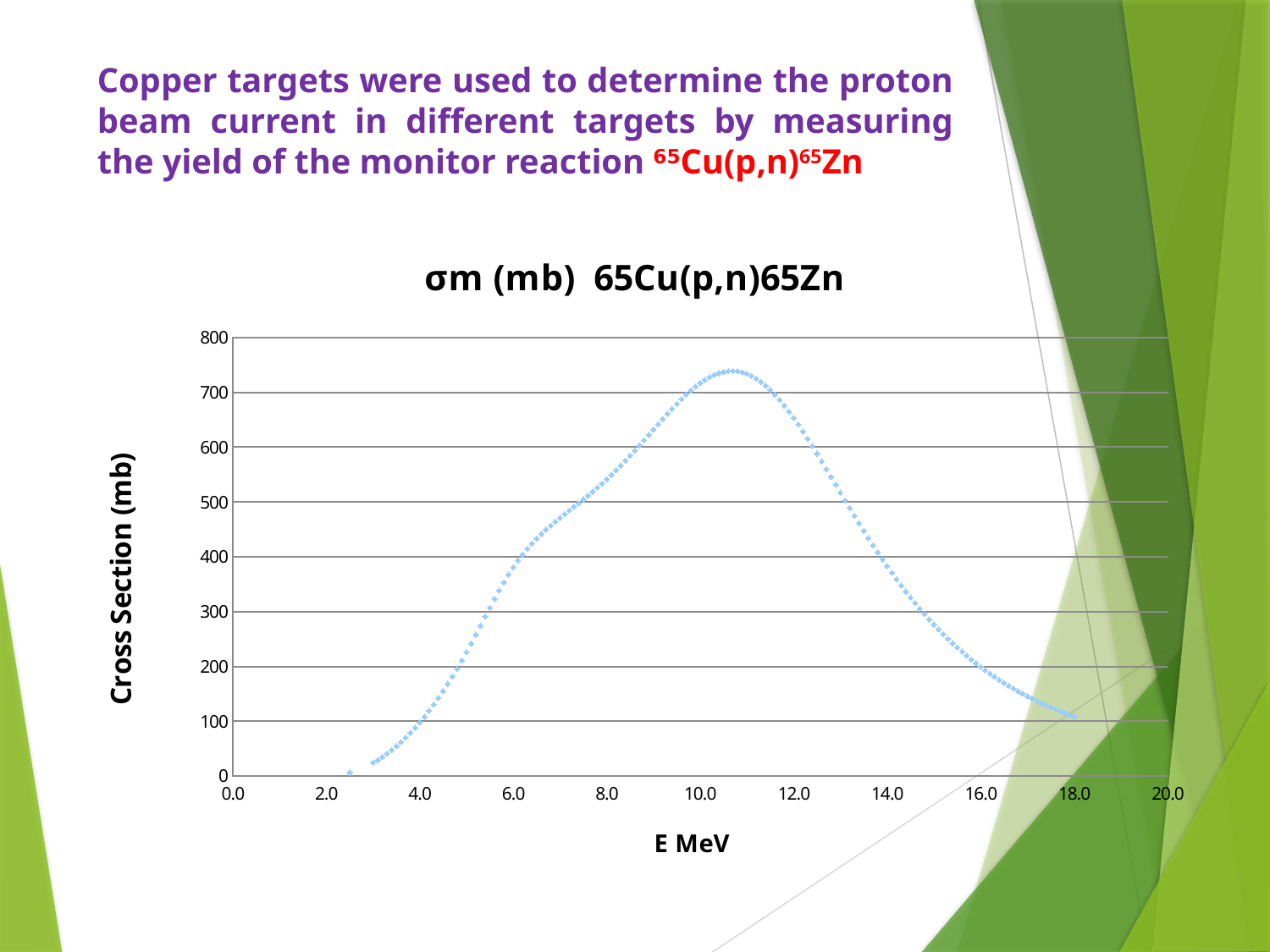
Is the peak cross section on the chart greater or less than 700 mb? greater Is the cross section at 12.0 MeV greater or less than 600 mb? greater What is the title of the chart? σm (mb) 65Cu(p,n)65Zn Does the cross section rise or fall as the energy increases from 12.0 MeV to 18.0 MeV? fall Between which two labelled x-axis ticks does the cross section reach its maximum? 10.0 and 12.0 What is the label of the vertical axis of the chart? Cross Section (mb) Is the cross section at 8.0 MeV greater or less than 500 mb? greater What kind of chart is shown on the slide? scatter chart Which is larger, the cross section at 8.0 MeV or at 14.0 MeV? 8.0 MeV Does the cross section rise or fall as the energy increases from 4.0 MeV to 10.0 MeV? rise